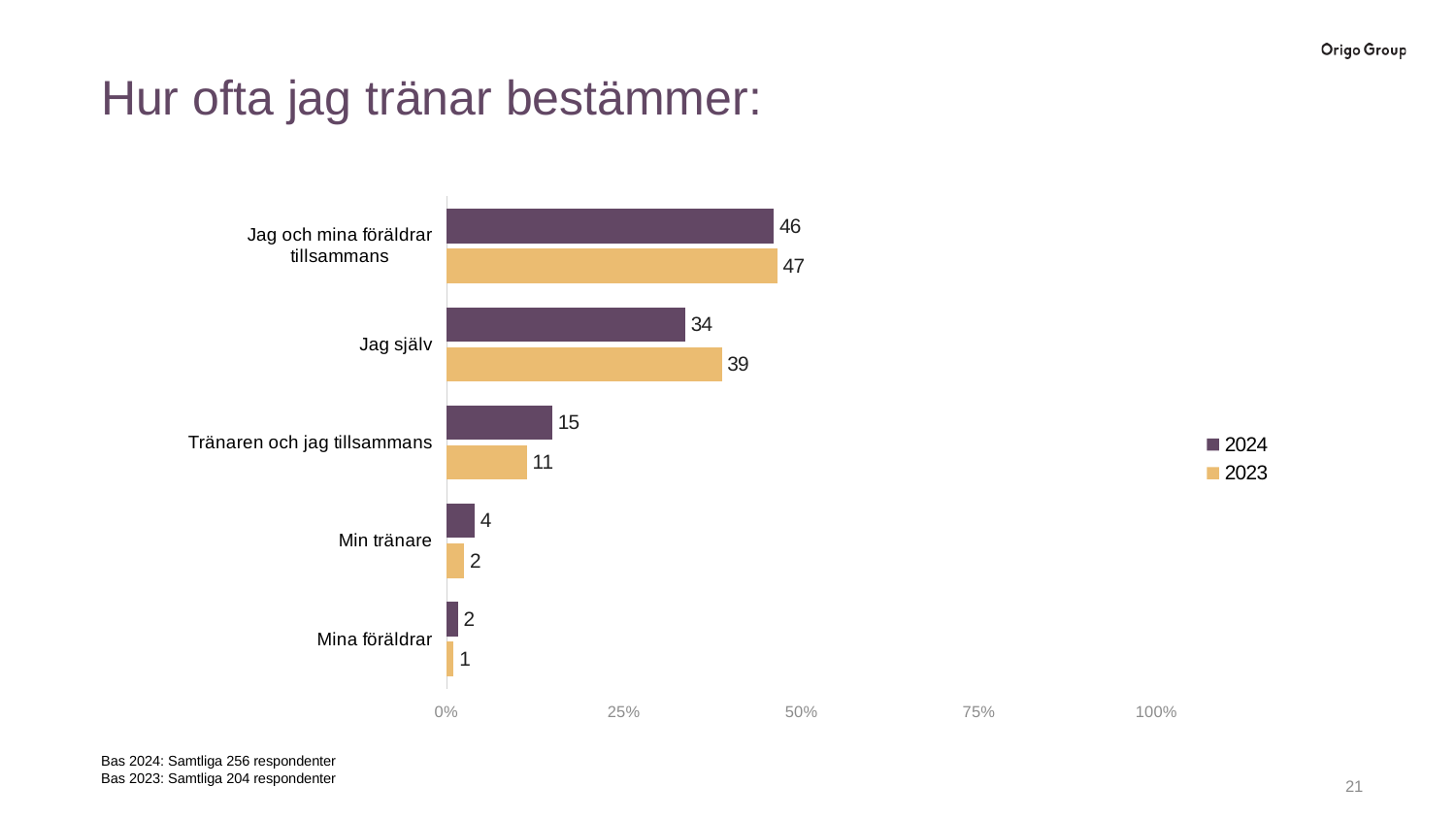
What is the difference between the 2023 and 2024 values for "Jag själv"? 5 How many series does the legend list? 2 Which category has the highest 2024 value? Jag och mina föräldrar tillsammans What kind of chart is shown on the slide? Bar chart Is the 2024 value for "Jag och mina föräldrar tillsammans" greater or less than 25%? greater Which category has the lowest 2023 value? Mina föräldrar What is the 2023 value for "Tränaren och jag tillsammans"? 11 What is the 2024 value for "Jag själv"? 34 How many categories are shown on the chart? 5 What is the 2023 value for "Jag och mina föräldrar tillsammans"? 47 Which colour represents the 2023 series? Yellow/orange For "Tränaren och jag tillsammans", which year has the larger value, 2024 or 2023? 2024